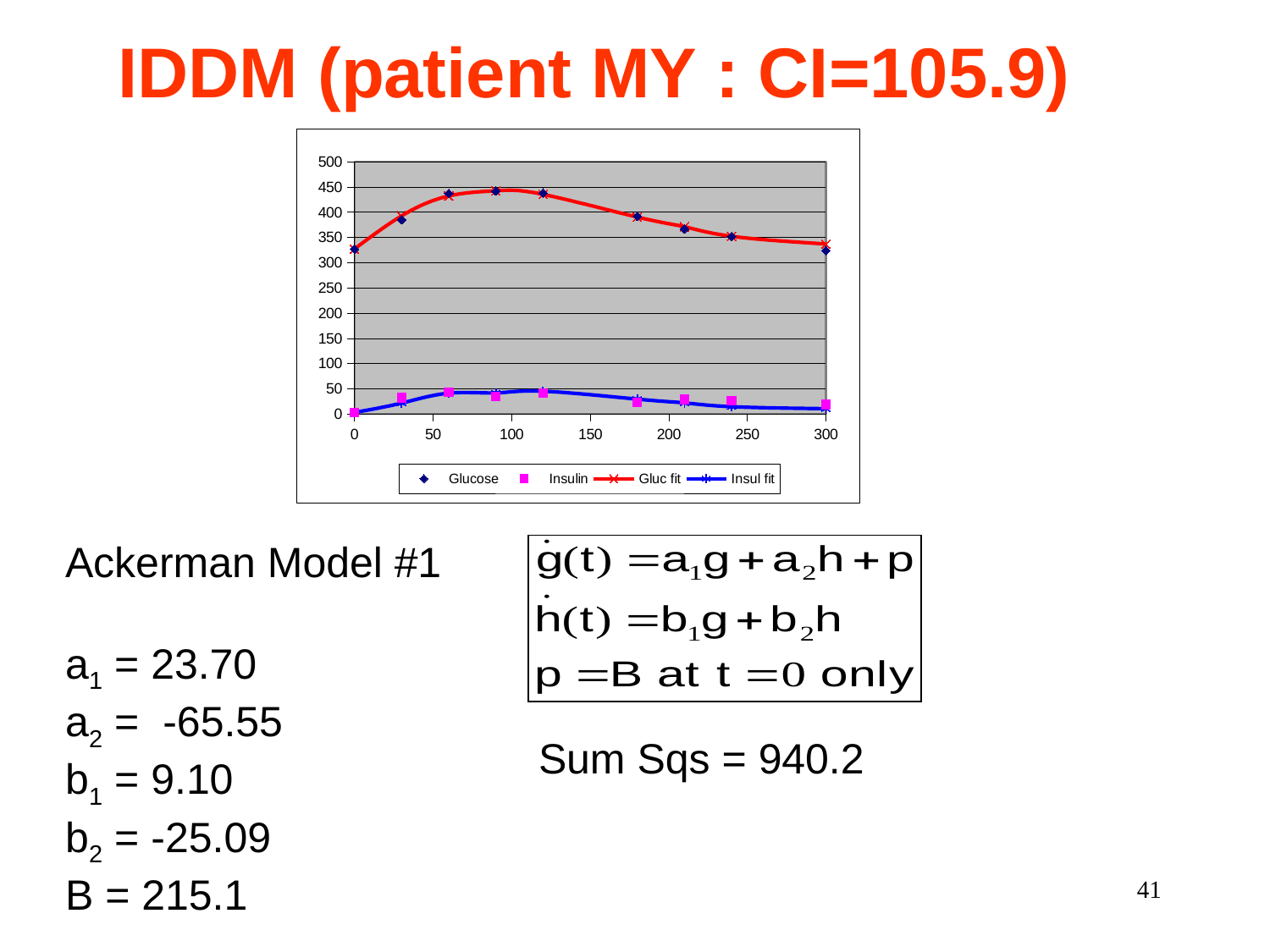
Is the Insulin value at x = 60 greater or less than 100? less Does the Gluc fit line rise or fall between x = 150 and x = 300? fall Is the Insulin value at x = 0 greater or less than 50? less Which series has larger values at x = 120, Glucose or Insulin? Glucose How many series does the chart legend list? 4 Does the Glucose series rise or fall between x = 0 and x = 90? rise What are the four legend entries of the chart? Glucose, Insulin, Gluc fit, Insul fit What kind of chart is shown on the slide? line chart What colour is the Gluc fit line? red Is the Glucose value at x = 90 greater or less than 400? greater What is the highest value shown on the y axis? 500